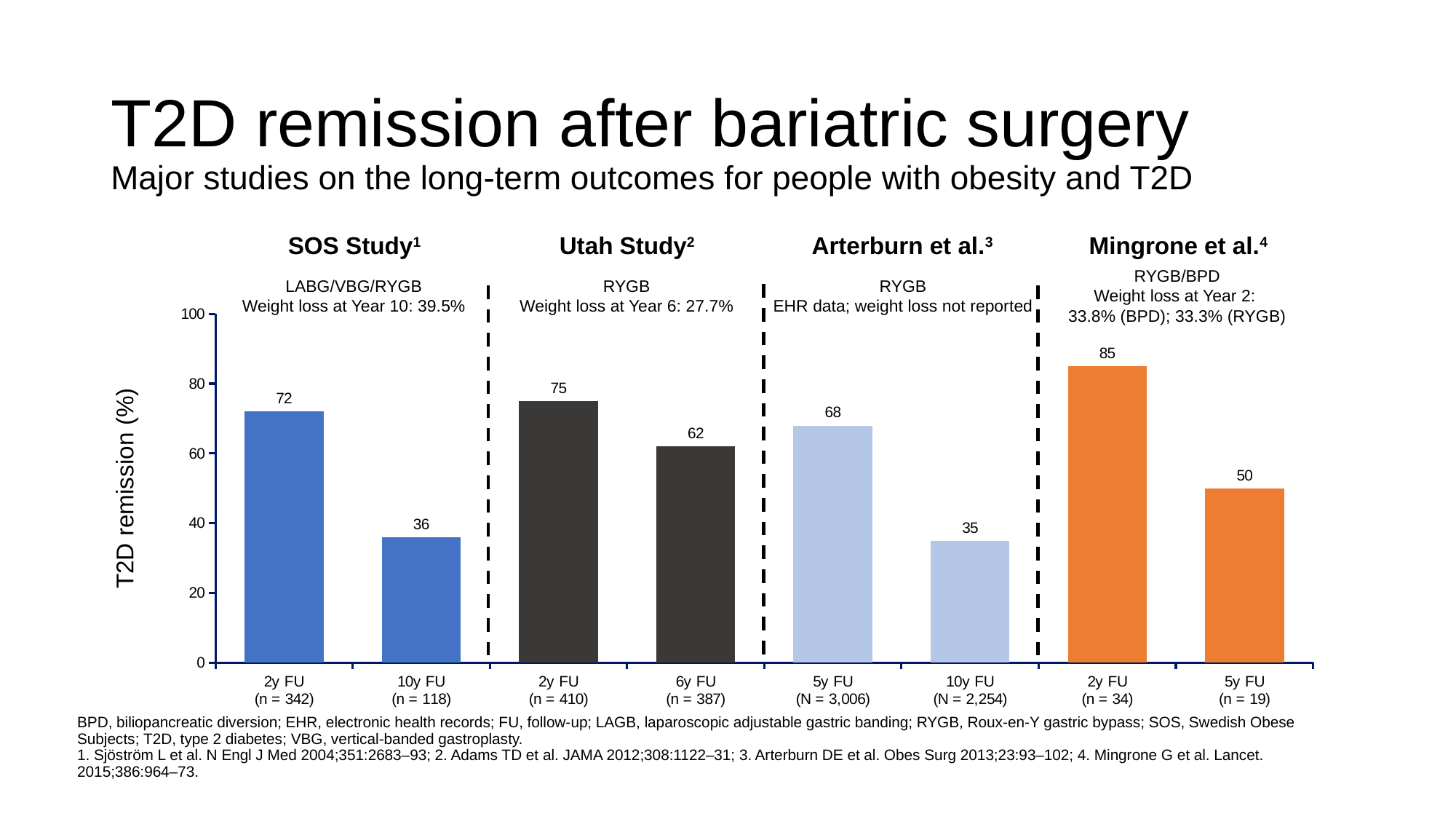
What is the label of the y axis? T2D remission (%) What is the T2D remission value for Arterburn et al. at 10y FU? 35 What is the T2D remission value for the Utah Study at 6y FU? 62 Which bar has the highest T2D remission value? Mingrone et al. 2y FU Which bar has the lowest T2D remission value? Arterburn et al. 10y FU What is the T2D remission value for Mingrone et al. at 5y FU? 50 What is the difference between the SOS Study 2y FU and 10y FU values? 36 What kind of chart is shown on the slide? Bar chart What is the difference between the Mingrone et al. 2y FU and 5y FU values? 35 How many bars are plotted in the chart? 8 Which is larger, the Utah Study 2y FU value or the Arterburn et al. 5y FU value? Utah Study 2y FU What is the T2D remission value for the SOS Study at 2y FU? 72